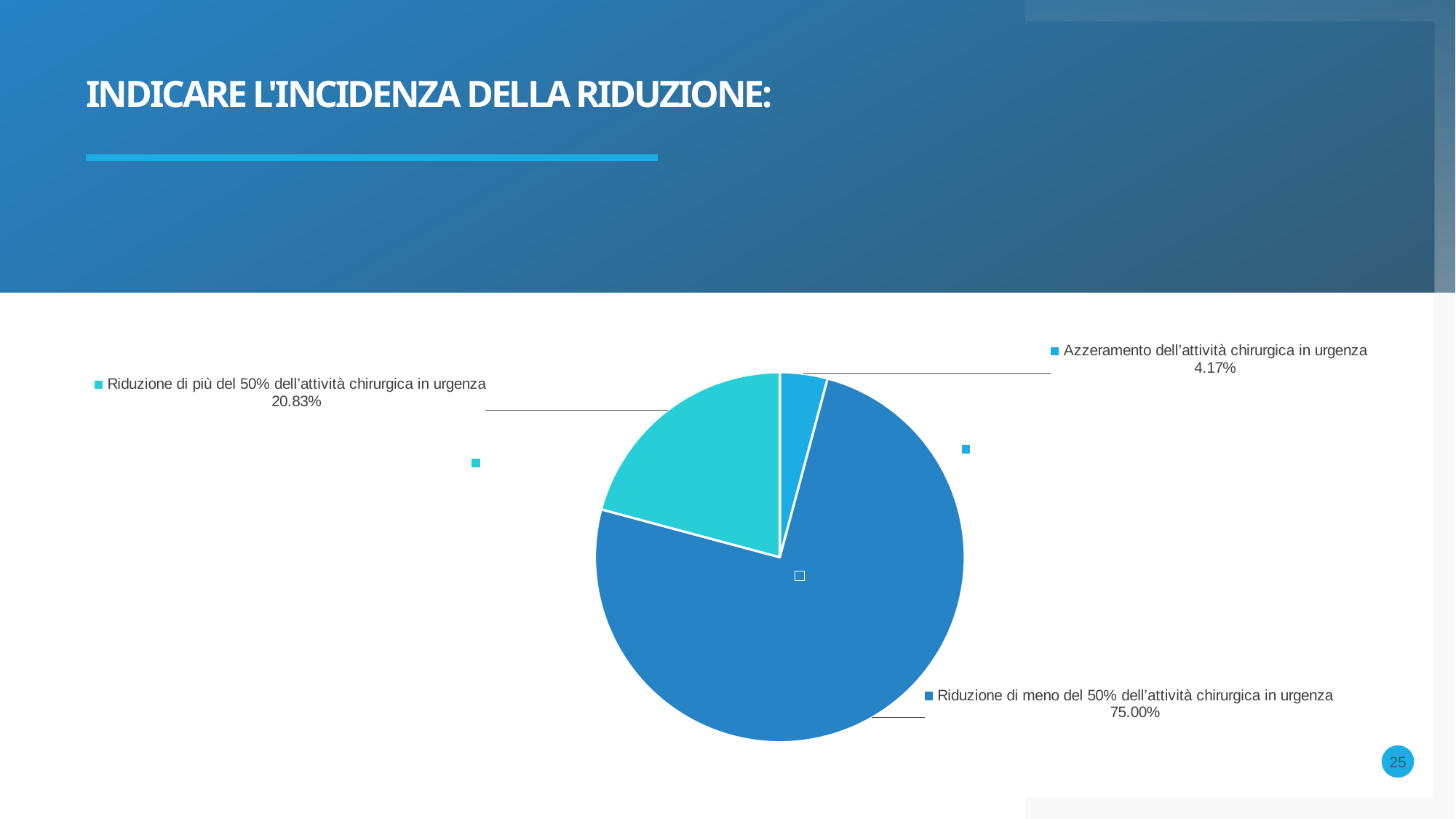
What share of the pie is 'Riduzione di più del 50% dell'attività chirurgica in urgenza'? 20.83% Which category has the smallest slice of the pie? Azzeramento dell'attività chirurgica in urgenza Which is larger: the slice for 'Riduzione di più del 50%' or the slice for 'Azzeramento dell'attività chirurgica in urgenza'? Riduzione di più del 50% dell'attività chirurgica in urgenza What kind of chart is shown on the slide? Pie chart Which category has the largest slice of the pie? Riduzione di meno del 50% dell'attività chirurgica in urgenza Is the slice for 'Riduzione di meno del 50% dell'attività chirurgica in urgenza' more or less than half of the pie? More How many slices does the pie chart have? 3 What is the difference in percentage points between 'Riduzione di più del 50%' and 'Azzeramento dell'attività chirurgica in urgenza'? 16.66 What is the difference in percentage points between 'Riduzione di meno del 50%' and 'Riduzione di più del 50%'? 54.17 What is the title of the slide containing the pie chart? INDICARE L'INCIDENZA DELLA RIDUZIONE: What share of the pie is 'Riduzione di meno del 50% dell'attività chirurgica in urgenza'? 75.00% What share of the pie is 'Azzeramento dell'attività chirurgica in urgenza'? 4.17%